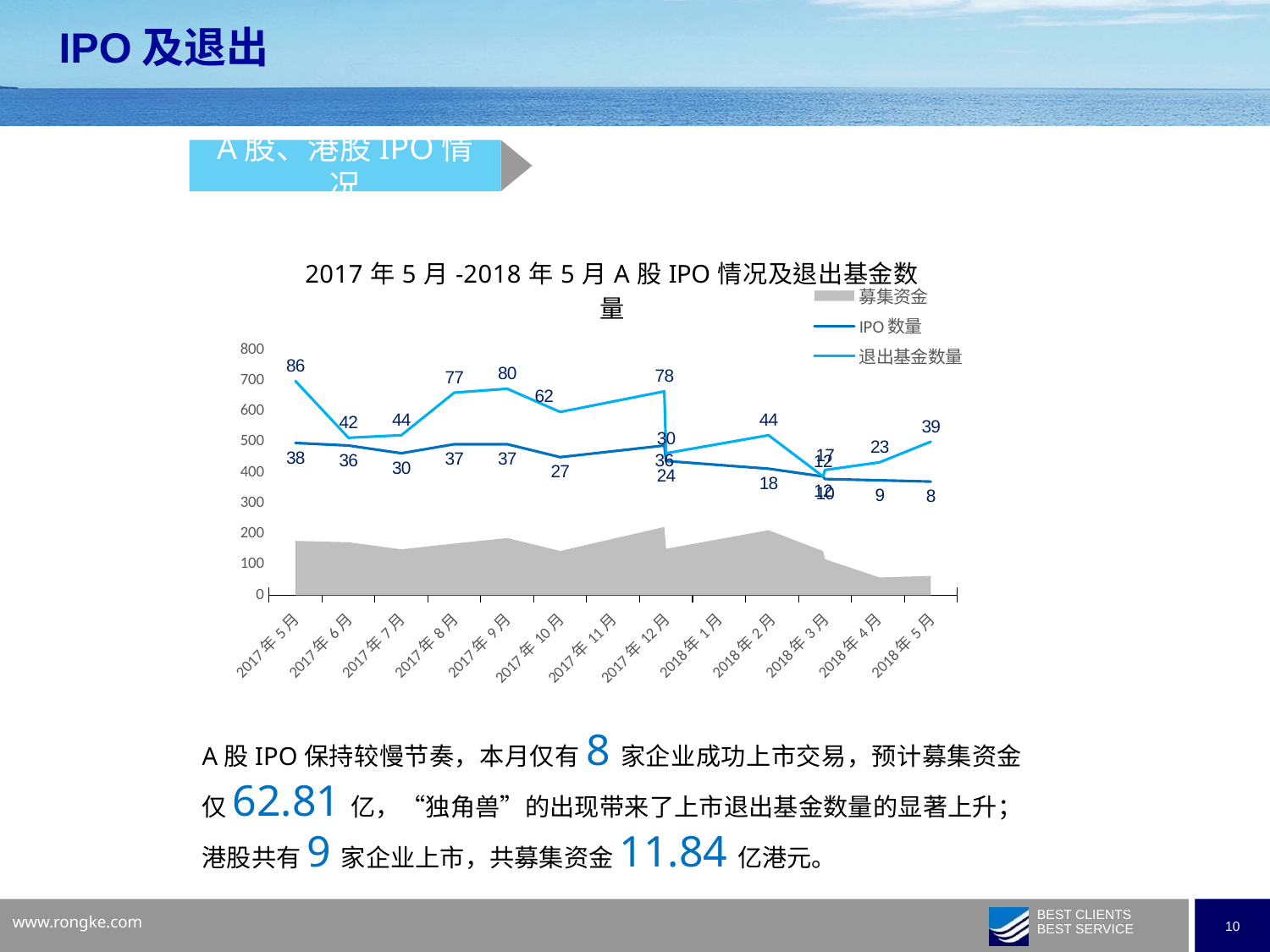
What is the 退出基金数量 value for 2017年9月? 80 What is the 退出基金数量 value for 2017年5月? 86 What is the IPO 数量 value for 2018年5月? 8 What is the difference between 退出基金数量 and IPO 数量 in 2017年5月? 48 How many series does the legend list? 3 Is the 募集资金 value for 2018年4月 greater or less than 100? less In which month is the IPO 数量 lowest? 2018年5月 Does the IPO 数量 rise or fall from 2018年2月 to 2018年5月? fall What is the IPO 数量 value for 2017年10月? 27 How many months are shown on the x axis? 13 In 2017年8月, which is larger: 退出基金数量 or IPO 数量? 退出基金数量 In which month is the 退出基金数量 highest? 2017年5月